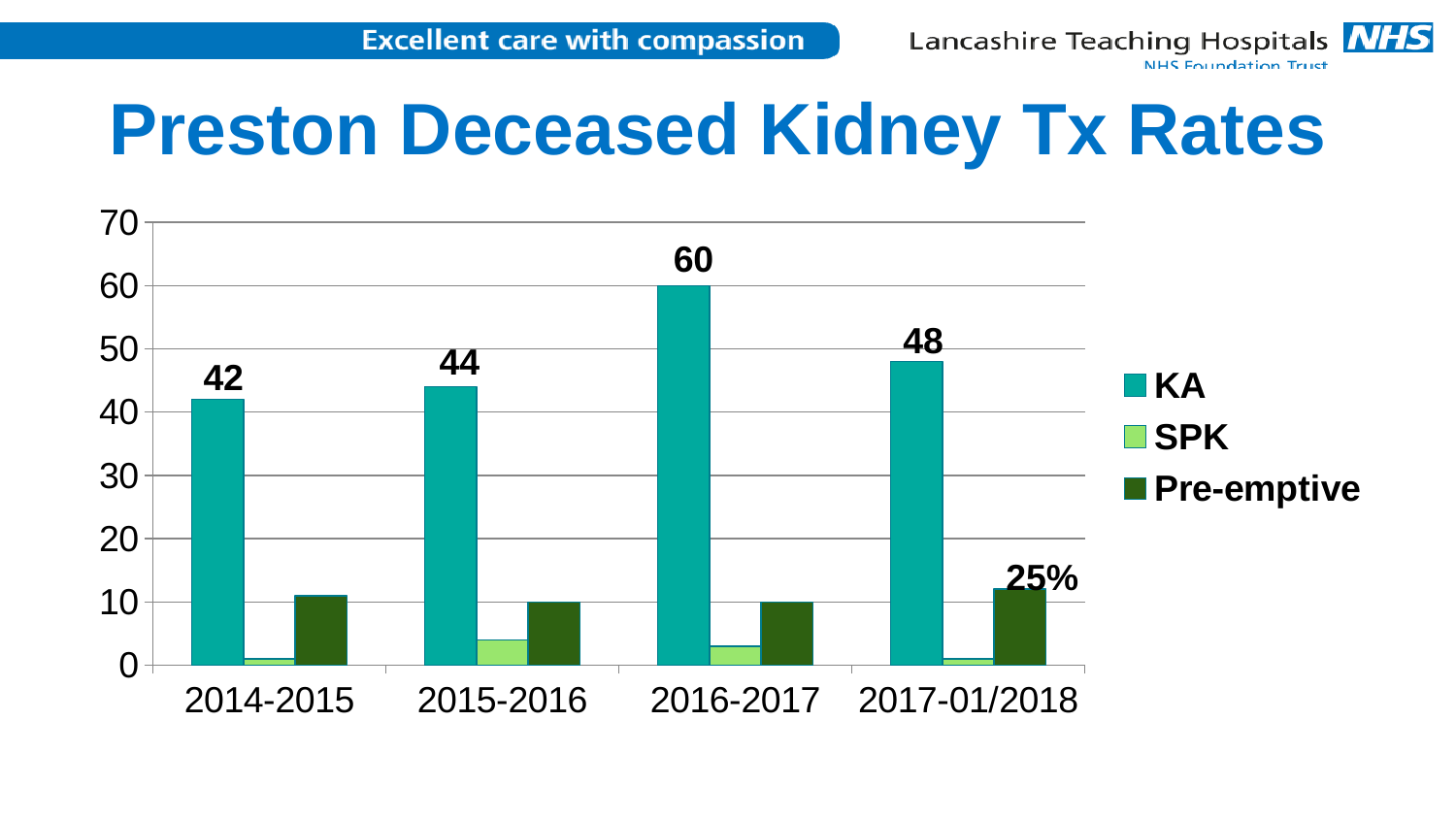
Which has the larger KA value, 2015-2016 or 2017-01/2018? 2017-01/2018 What is the difference between the KA values for 2016-2017 and 2017-01/2018? 12 Is the Pre-emptive value for 2014-2015 greater or less than 20? less How many series does the legend list? 3 Does the KA value rise or fall from 2014-2015 to 2016-2017? rise In which period is the KA value lowest? 2014-2015 How many periods are shown on the x axis? 4 What is the KA value for 2014-2015? 42 In which period is the KA value highest? 2016-2017 What is the KA value for 2016-2017? 60 What kind of chart is shown on the slide? bar chart What data label is printed on the Pre-emptive bar for 2017-01/2018? 25%